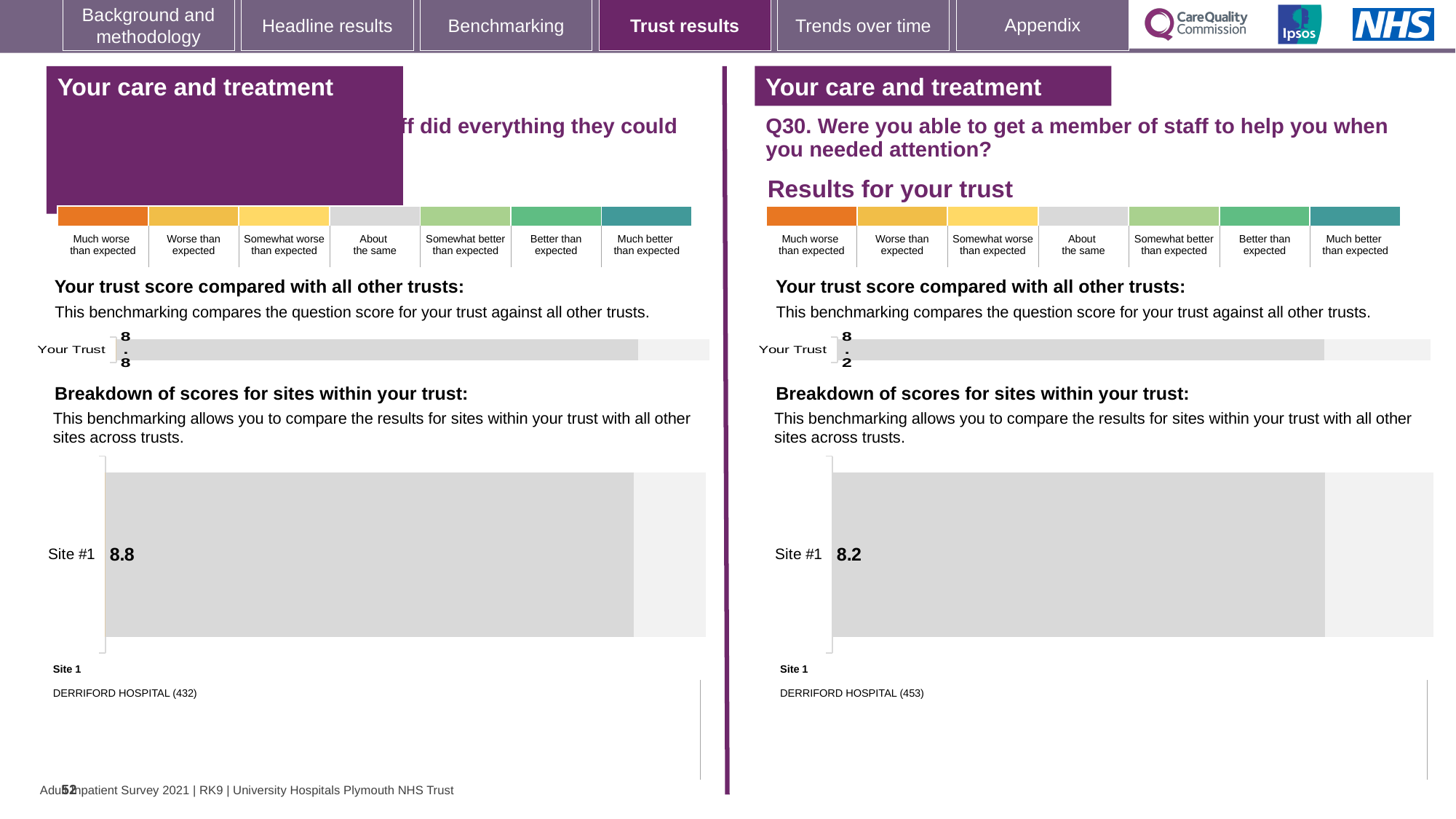
On the right panel (Q30), what is the score shown for Your Trust? 8.2 On the left panel, what is the score shown for Your Trust? 8.8 What is the difference between the Site #1 score on the left panel and the Site #1 score on the right panel (Q30)? 0.6 On the right panel's (Q30) breakdown of scores for sites, what is the score for Site #1? 8.2 On the left panel, which hospital is listed as Site 1? DERRIFORD HOSPITAL (432) What kind of chart is used to show the Site #1 score on the left panel? bar chart On the right panel (Q30), which hospital is listed as Site 1? DERRIFORD HOSPITAL (453) Which panel shows the higher Your Trust score, the left panel or the right panel (Q30)? left panel Is the Your Trust score on the right panel (Q30) greater or less than the Your Trust score on the left panel? less On the left panel's breakdown of scores for sites, what is the score for Site #1? 8.8 How many sites are listed in the breakdown of scores on the right panel (Q30)? 1